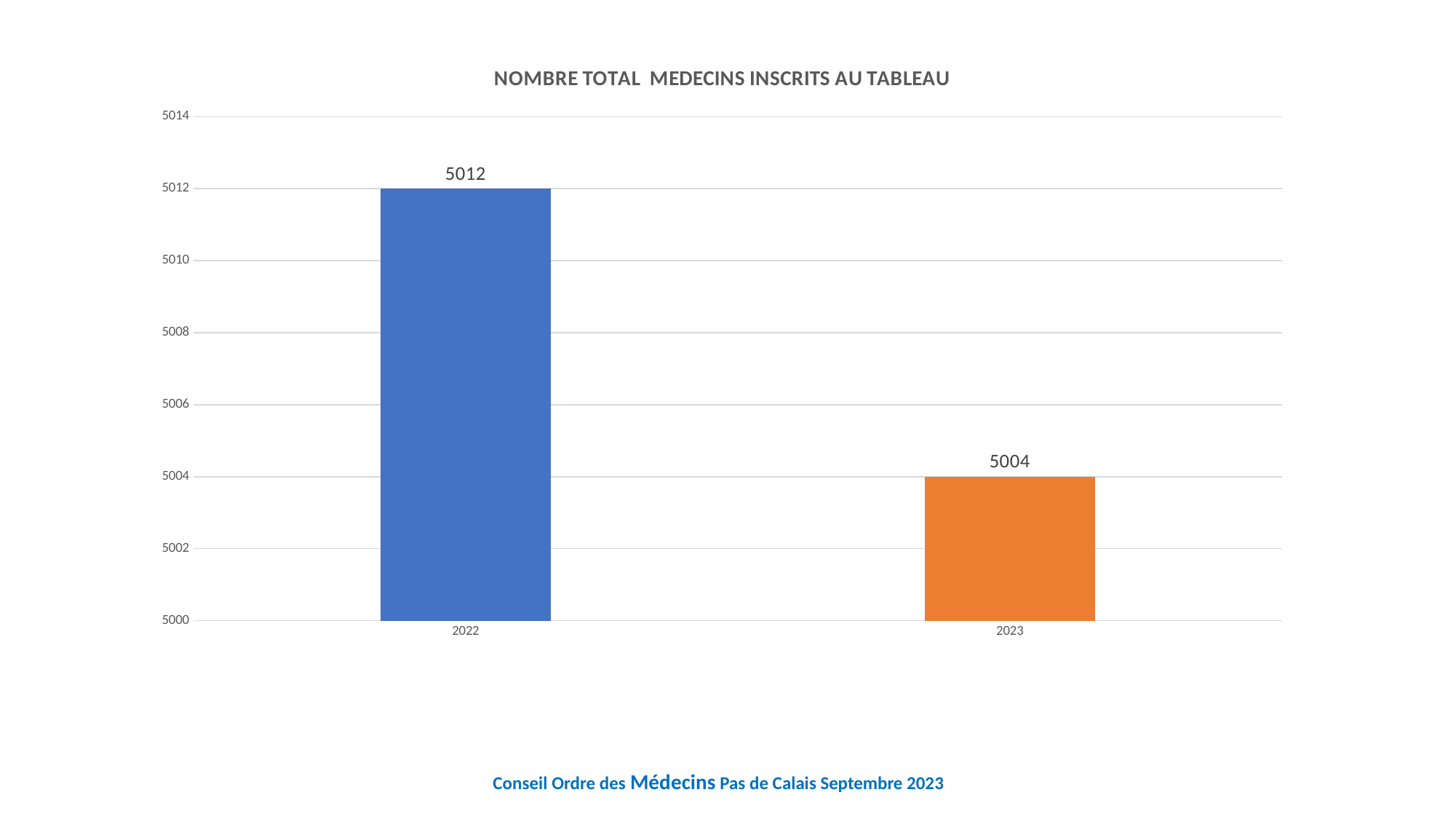
Which is larger, the value for 2022 or the value for 2023? 2022 Which year has the lowest value? 2023 Is the value for 2023 greater or less than 5006? less What kind of chart is shown on the slide? bar chart What is the title of the chart? NOMBRE TOTAL MEDECINS INSCRITS AU TABLEAU How many categories are shown on the x axis? 2 Is the value for 2022 greater or less than 5010? greater What is the value for 2023? 5004 Do the values rise or fall from 2022 to 2023? fall What is the value for 2022? 5012 Which year has the highest value? 2022 What is the difference between the values for 2022 and 2023? 8